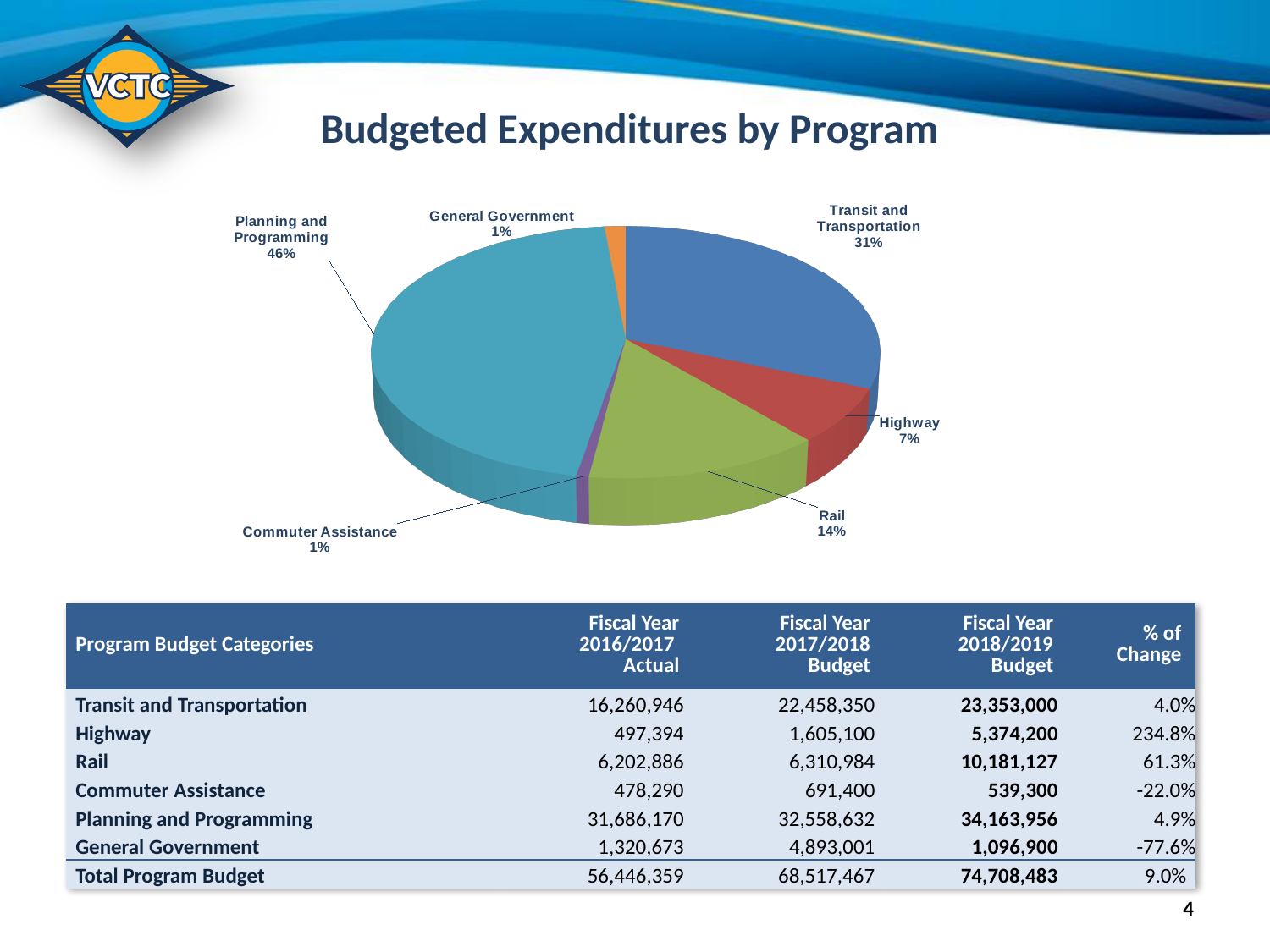
What share of the pie does Planning and Programming represent? 46% What share of the pie does General Government represent? 1% What is the difference in percentage points between the Rail slice and the Highway slice? 7% Which slice is larger, Rail or Highway? Rail What share of the pie does Highway represent? 7% What is the difference in percentage points between the Planning and Programming slice and the Transit and Transportation slice? 15% How many slices does the pie chart have? 6 What is the title of the slide containing the pie chart? Budgeted Expenditures by Program Which category has the largest slice of the pie? Planning and Programming What kind of chart is shown on the slide? Pie chart